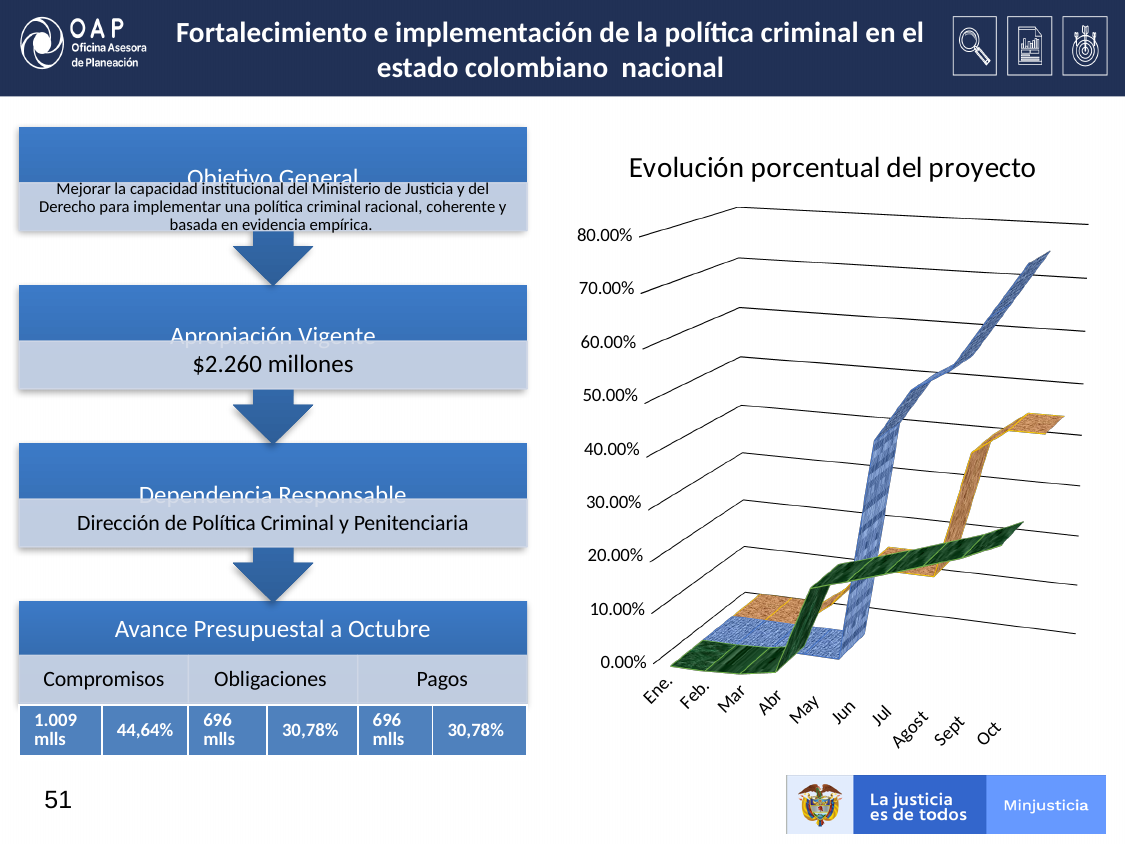
In the 'Evolución porcentual del proyecto' chart, which series has the lowest value in Oct? the green series In the 'Evolución porcentual del proyecto' chart, which series has the highest value in Oct? the blue series In the 'Evolución porcentual del proyecto' chart, is the value of the green series in Ene. greater or less than 10.00%? less What is the highest value shown on the vertical axis of the 'Evolución porcentual del proyecto' chart? 80.00% What kind of chart is 'Evolución porcentual del proyecto'? 3D line chart In the 'Evolución porcentual del proyecto' chart, do the values of the blue series rise or fall from Jun to Oct? rise What is the last month label on the x axis of the 'Evolución porcentual del proyecto' chart? Oct What is the title of the chart on the right side of the slide? Evolución porcentual del proyecto How many series are plotted in the 'Evolución porcentual del proyecto' chart? 3 In the 'Evolución porcentual del proyecto' chart, is the value of the blue series in Oct greater or less than the value of the orange series in Oct? greater How many months are shown on the x axis of the 'Evolución porcentual del proyecto' chart? 10 What is the first month label on the x axis of the 'Evolución porcentual del proyecto' chart? Ene.